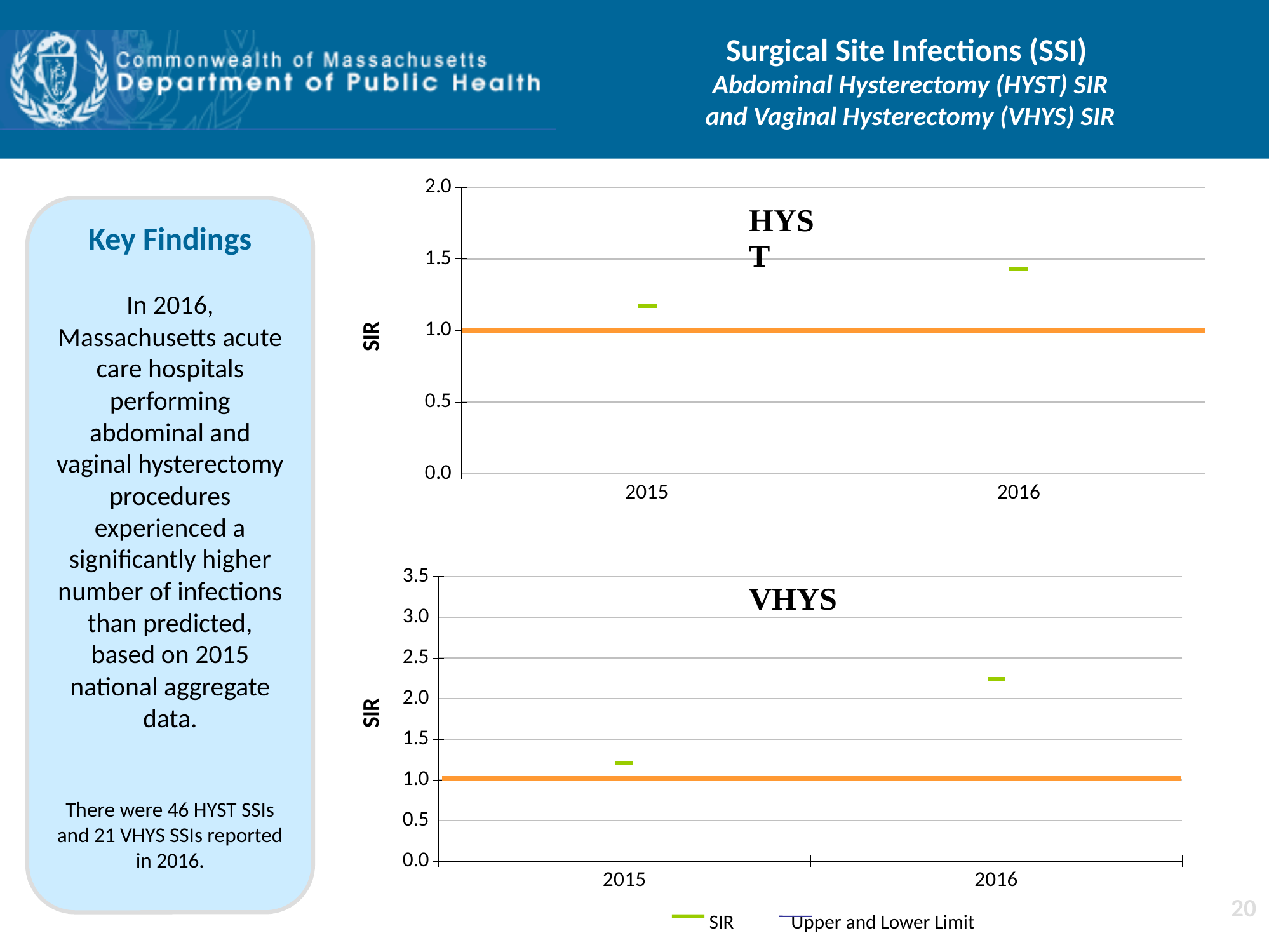
How many years are shown on the x axis of the HYST chart? 2 In the HYST chart, which year has the higher SIR, 2015 or 2016? 2016 What is the title of the bottom chart? VHYS In the VHYS chart, is the SIR value for 2016 greater or less than 2.0? greater In the VHYS chart, is the SIR value for 2015 greater or less than 1.5? less In the HYST chart, is the SIR value for 2016 greater or less than 1.0? greater What is the y-axis label on the HYST chart? SIR In the VHYS chart, does the SIR rise or fall from 2015 to 2016? rise In the HYST chart, does the SIR rise or fall from 2015 to 2016? rise In the VHYS chart, which year has the lower SIR? 2015 How many series does the legend at the bottom of the slide list? 2